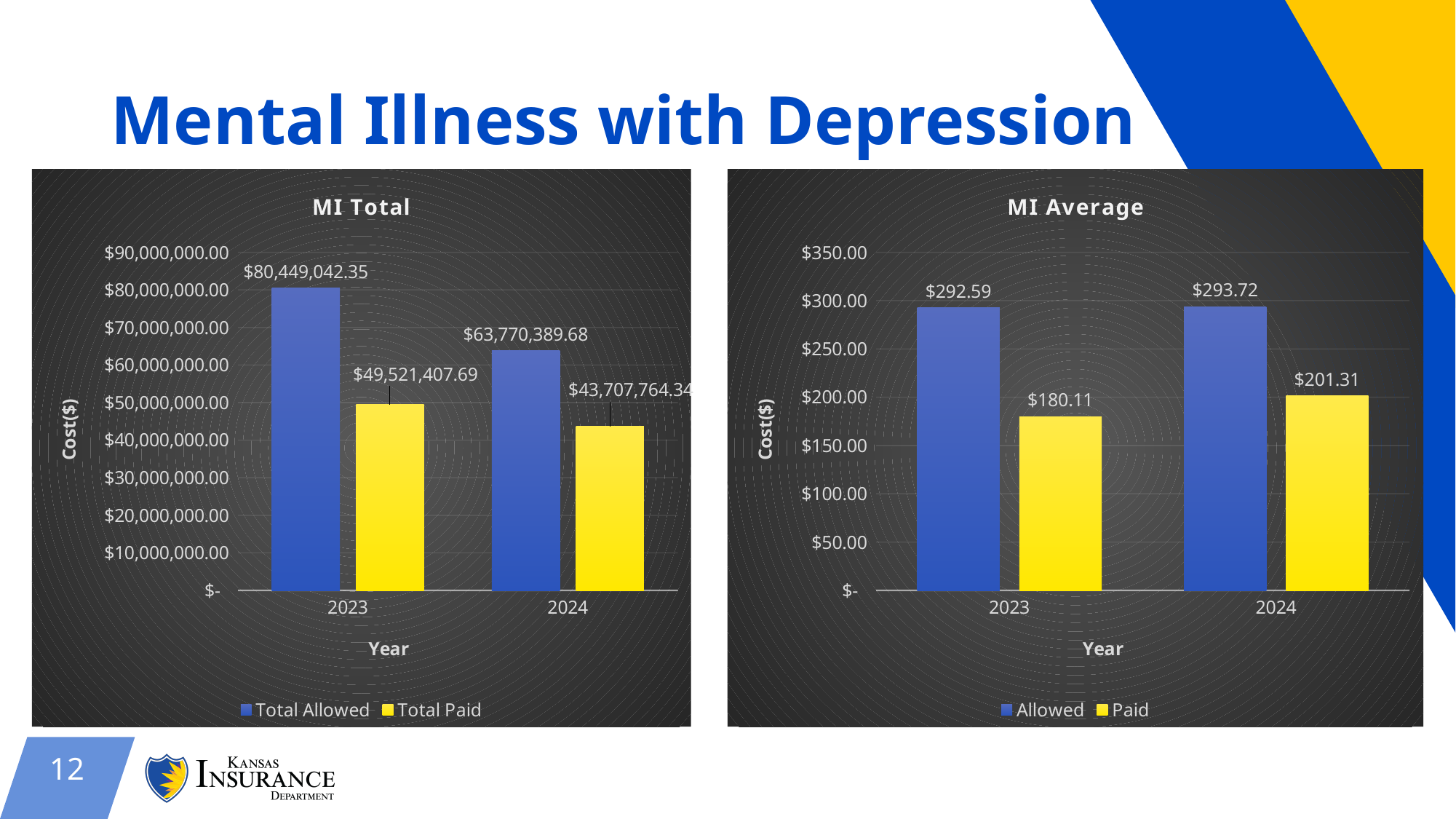
In the MI Average chart, which year has the lower Paid value? 2023 In the MI Total chart, what is the Total Paid value for 2024? $43,707,764.34 In the MI Average chart, what is the Allowed value for 2024? $293.72 What kind of chart is the MI Total chart? bar chart In the MI Total chart, what is the difference between Total Allowed and Total Paid in 2023? $30,927,634.66 How many series does the legend of the MI Average chart list? 2 In the MI Total chart, is the Total Paid value for 2023 larger or smaller than the Total Allowed value for 2024? smaller In the MI Average chart, what is the difference between the Paid values for 2024 and 2023? $21.20 In the MI Total chart, what is the Total Allowed value for 2023? $80,449,042.35 In the MI Total chart, does the Total Allowed value rise or fall from 2023 to 2024? fall In the MI Average chart, what is the Paid value for 2023? $180.11 In the MI Total chart, which year has the higher Total Allowed value? 2023